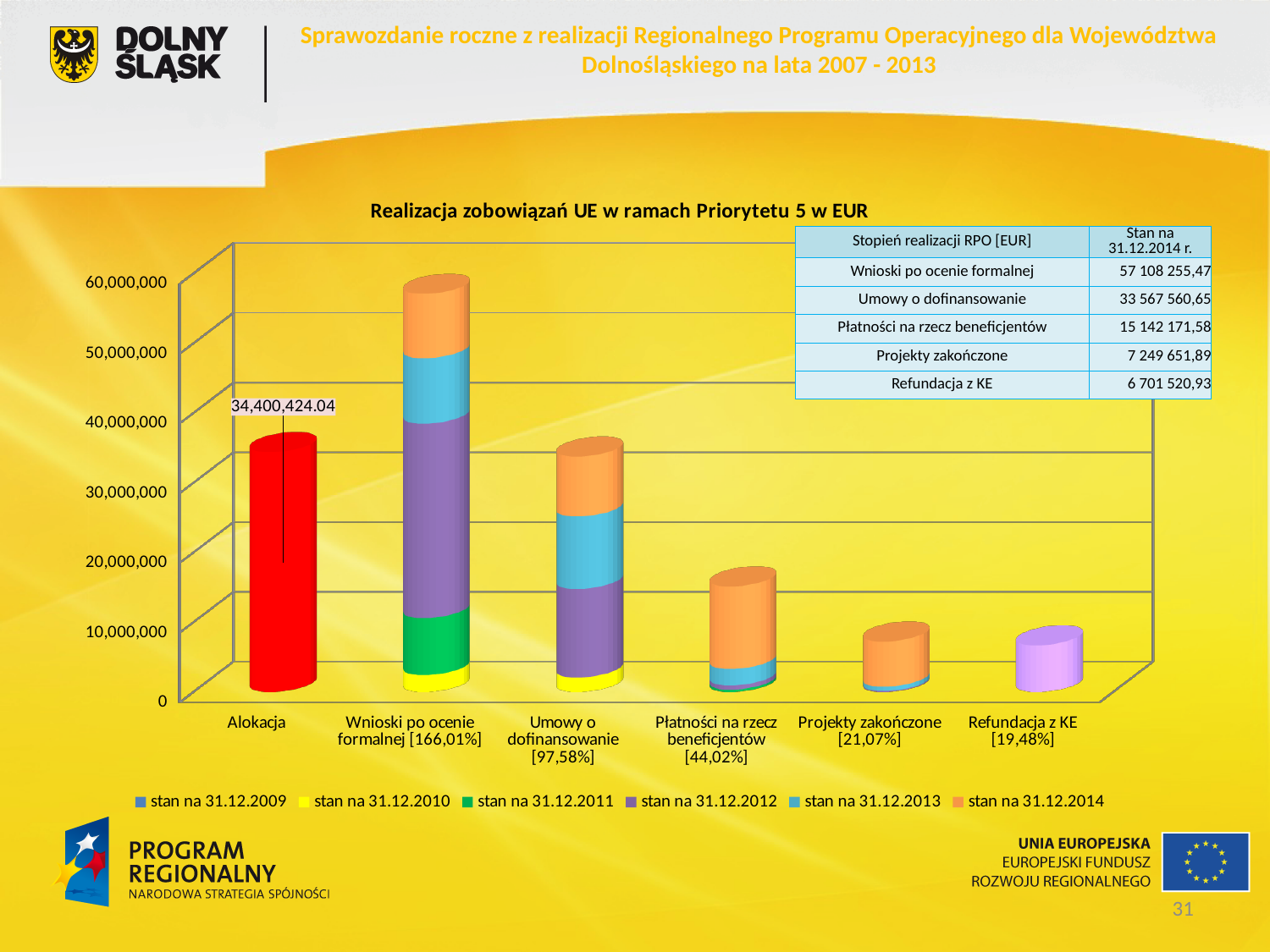
How many categories are shown on the x axis? 6 According to the table, what is the value for Wnioski po ocenie formalnej as of 31.12.2014? 57 108 255,47 What type of chart is shown on the slide? bar chart Which is larger, Wnioski po ocenie formalnej or Umowy o dofinansowanie? Wnioski po ocenie formalnej Which category has the shortest bar? Refundacja z KE According to the table, what is the value for Refundacja z KE as of 31.12.2014? 6 701 520,93 Is the value for Płatności na rzecz beneficjentów greater or less than 20,000,000? less What value is labelled on the Alokacja bar? 34,400,424.04 How many series does the legend list? 6 What is the title of the chart? Realizacja zobowiązań UE w ramach Priorytetu 5 w EUR Which category has the tallest bar? Wnioski po ocenie formalnej Using the table values, what is the difference between Wnioski po ocenie formalnej and Umowy o dofinansowanie? 23 540 694,82